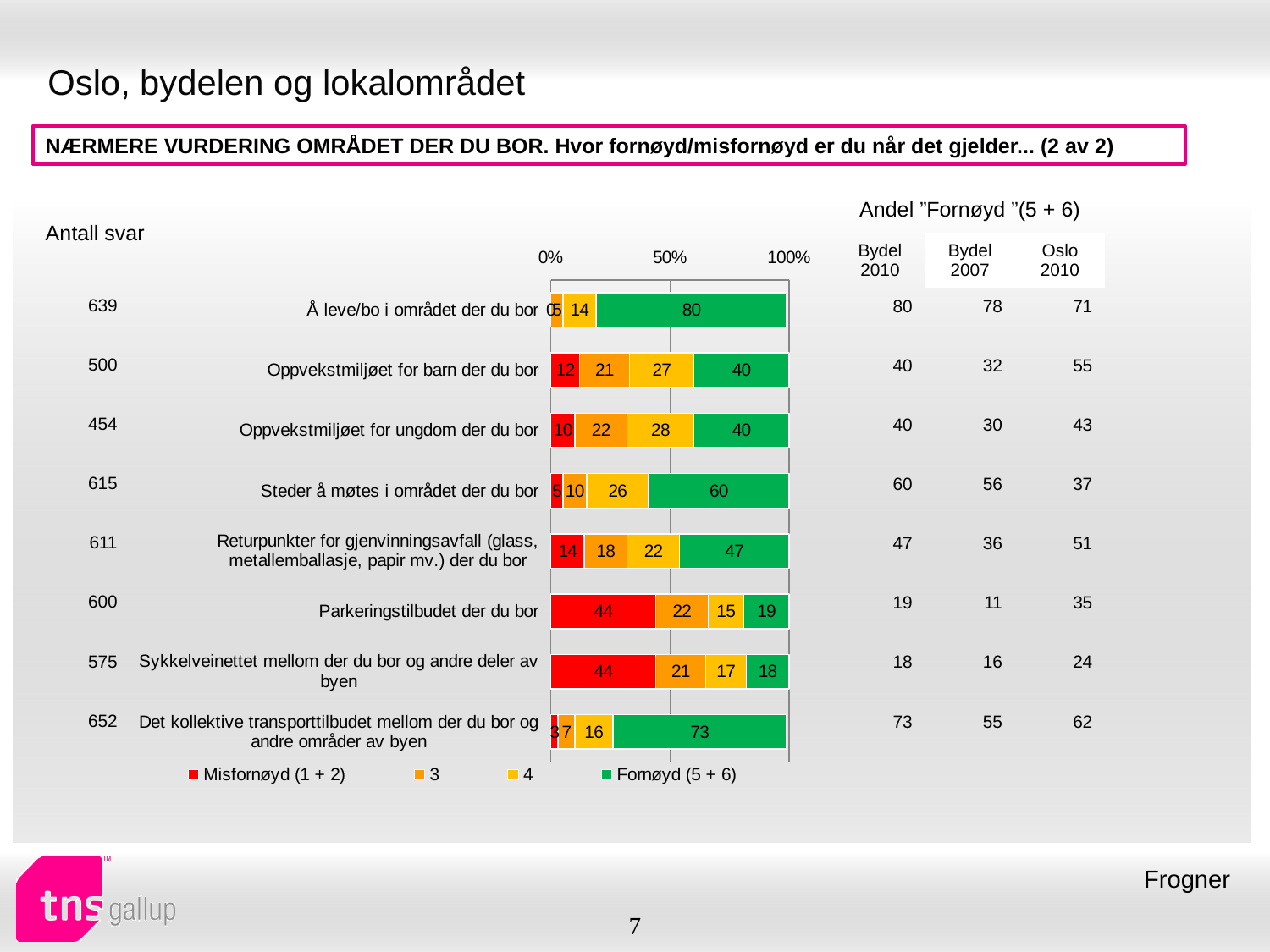
What is the value of the "Fornøyd (5 + 6)" series for "Parkeringstilbudet der du bor"? 19 What is the value of the "Misfornøyd (1 + 2)" series for "Sykkelveinettet mellom der du bor og andre deler av byen"? 44 What kind of chart is shown on the slide? Stacked bar chart Which has a larger "Misfornøyd (1 + 2)" value: "Parkeringstilbudet der du bor" or "Returpunkter for gjenvinningsavfall (glass, metallemballasje, papir mv.) der du bor"? Parkeringstilbudet der du bor What is the difference between the "Fornøyd (5 + 6)" and "Misfornøyd (1 + 2)" values for "Oppvekstmiljøet for barn der du bor"? 28 What is the value of the "3" series for "Oppvekstmiljøet for ungdom der du bor"? 22 Which category has the lowest "Fornøyd (5 + 6)" value? Sykkelveinettet mellom der du bor og andre deler av byen How many categories are shown in the chart? 8 What is the total of the stacked bar for "Oppvekstmiljøet for barn der du bor"? 100 What colour represents the "Fornøyd (5 + 6)" series in the chart? Green How many series does the legend list? 4 Which category has the highest "Fornøyd (5 + 6)" value? Å leve/bo i området der du bor